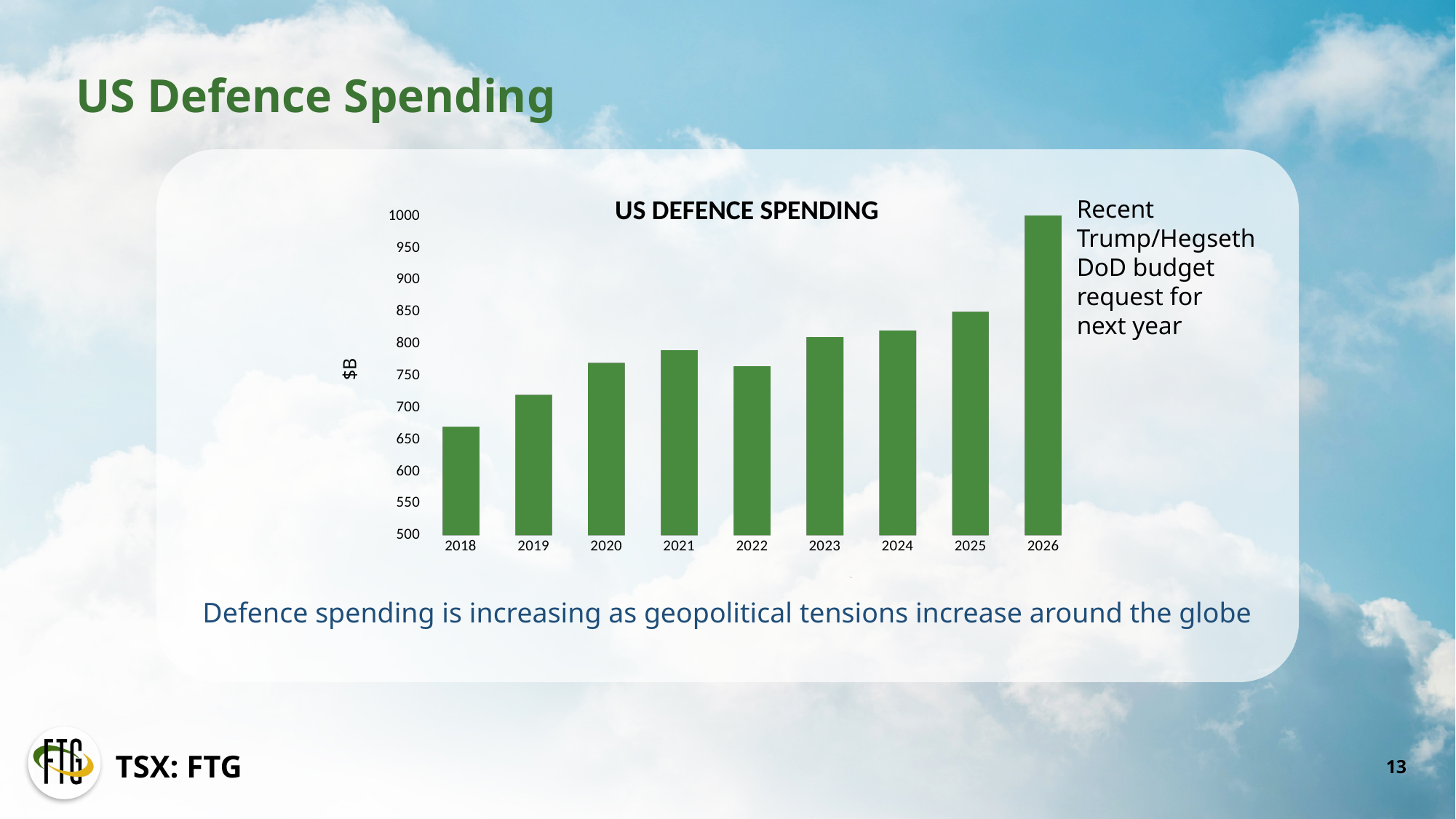
What is the title of the chart? US DEFENCE SPENDING What kind of chart is shown on the slide? Bar chart Is the value for 2018 greater or less than 700? less Which year has the lowest US defence spending on the chart? 2018 Is the value for 2025 greater or less than 800? greater Which year has the larger value, 2021 or 2022? 2021 What is the label on the vertical axis of the chart? $B Which year has the highest US defence spending on the chart? 2026 Do the values generally rise or fall from 2018 to 2026? Rise Is the value for 2026 greater or less than 950? greater How many years are plotted on the US DEFENCE SPENDING chart? 9